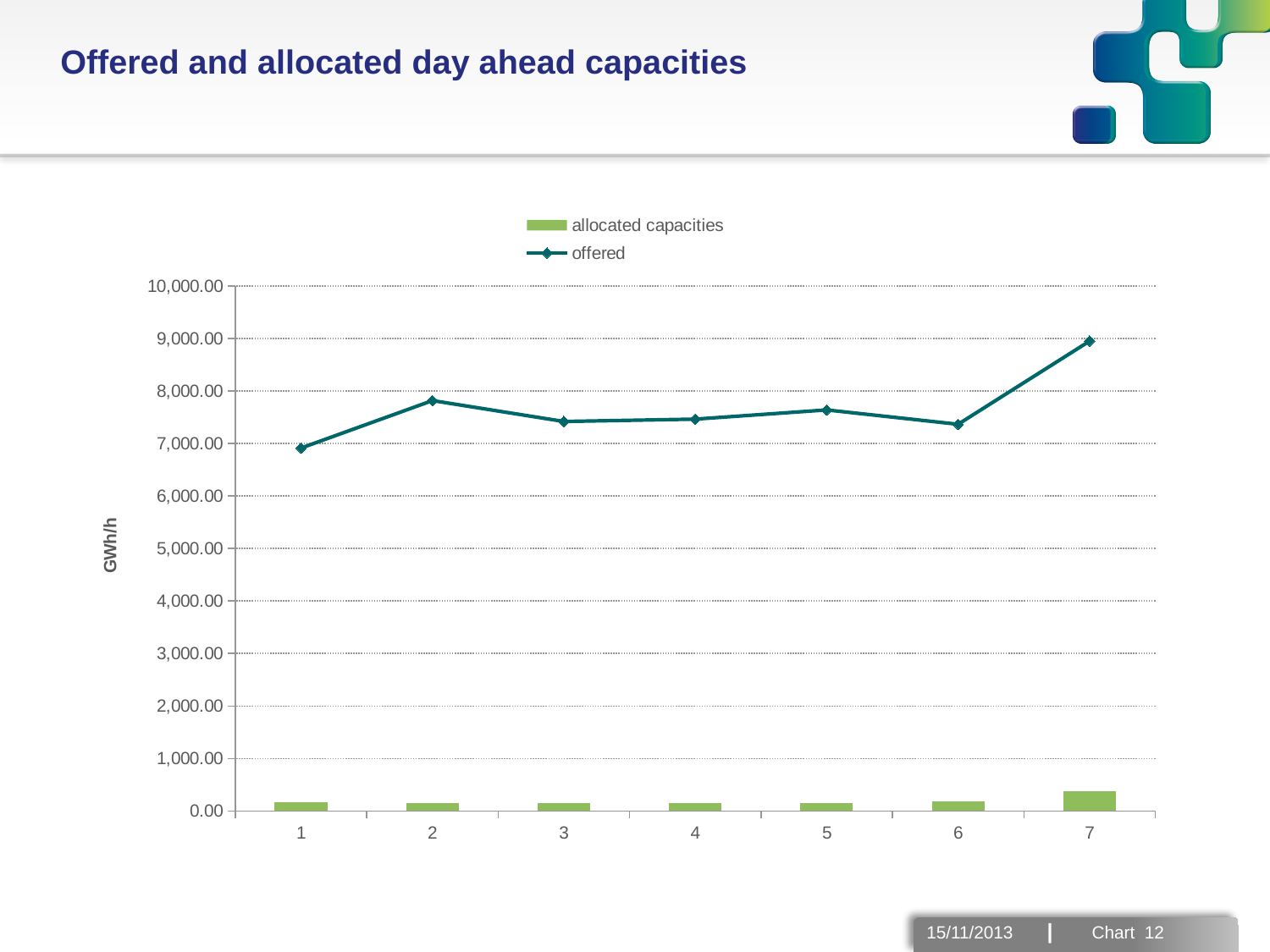
What is the label on the vertical axis? GWh/h Which category has the highest value for the offered series? 7 Is the offered value for category 2 greater or less than 7,000.00? greater Is the allocated capacities value for category 7 greater or less than 1,000.00? less Is the offered value for category 7 greater or less than 8,000.00? greater How many categories are shown on the x axis? 7 Does the offered series rise or fall from category 6 to category 7? rise How many series does the legend list? 2 Which category has the lowest value for the offered series? 1 Which is larger, the offered value for category 7 or for category 1? category 7 Which is larger, the allocated capacities value for category 7 or for category 1? category 7